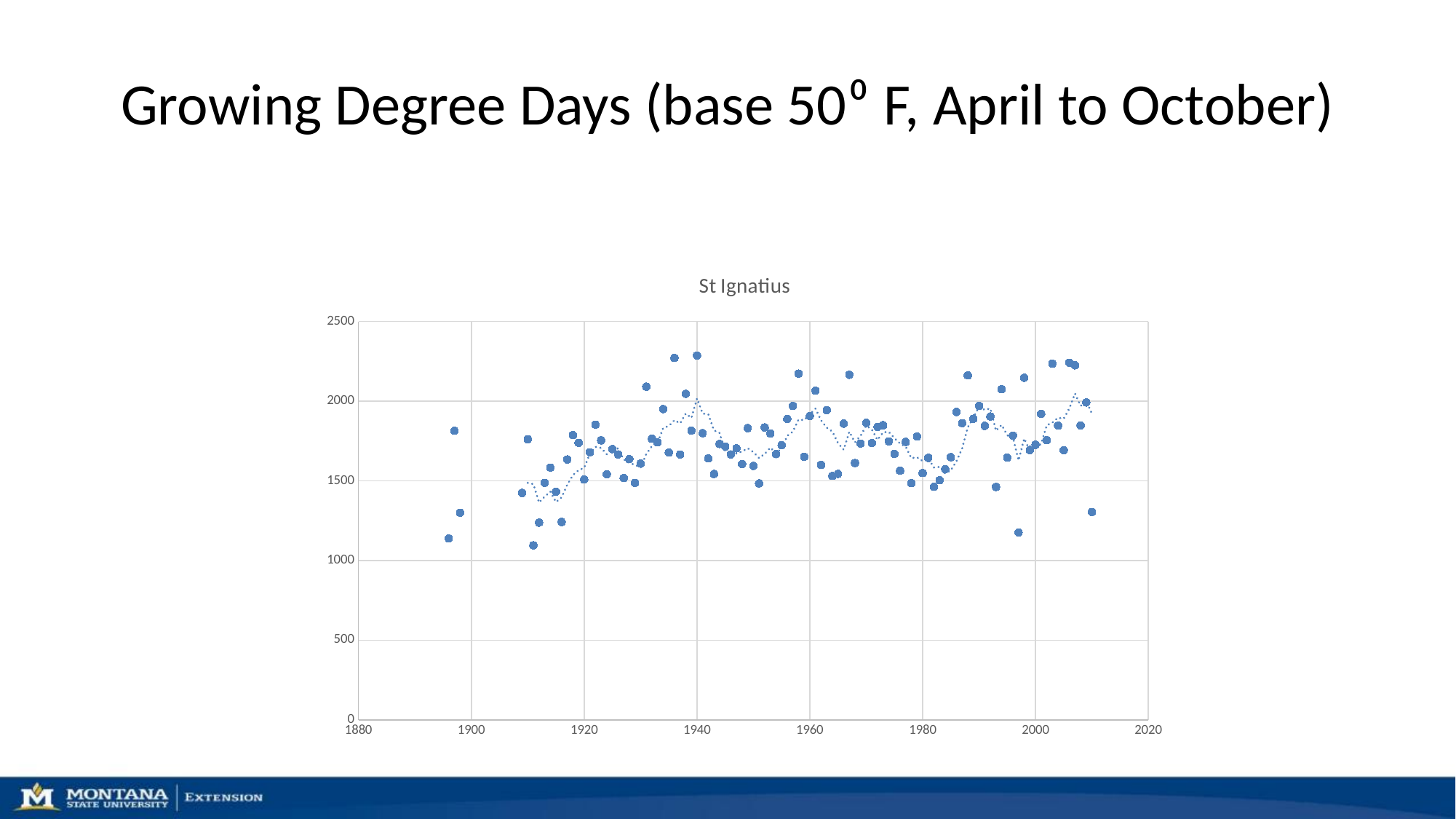
Is the lowest plotted point on the chart greater or less than 1000? greater What is the title of the chart? St Ignatius What kind of chart is shown on the slide? scatter plot Do the plotted values generally rise or fall from the early 1900s to the 2000s? rise Is the highest plotted point on the chart greater or less than 2500? less Are the plotted points around 1940 greater or less than 1000? greater What is the highest value shown on the chart's y axis? 2500